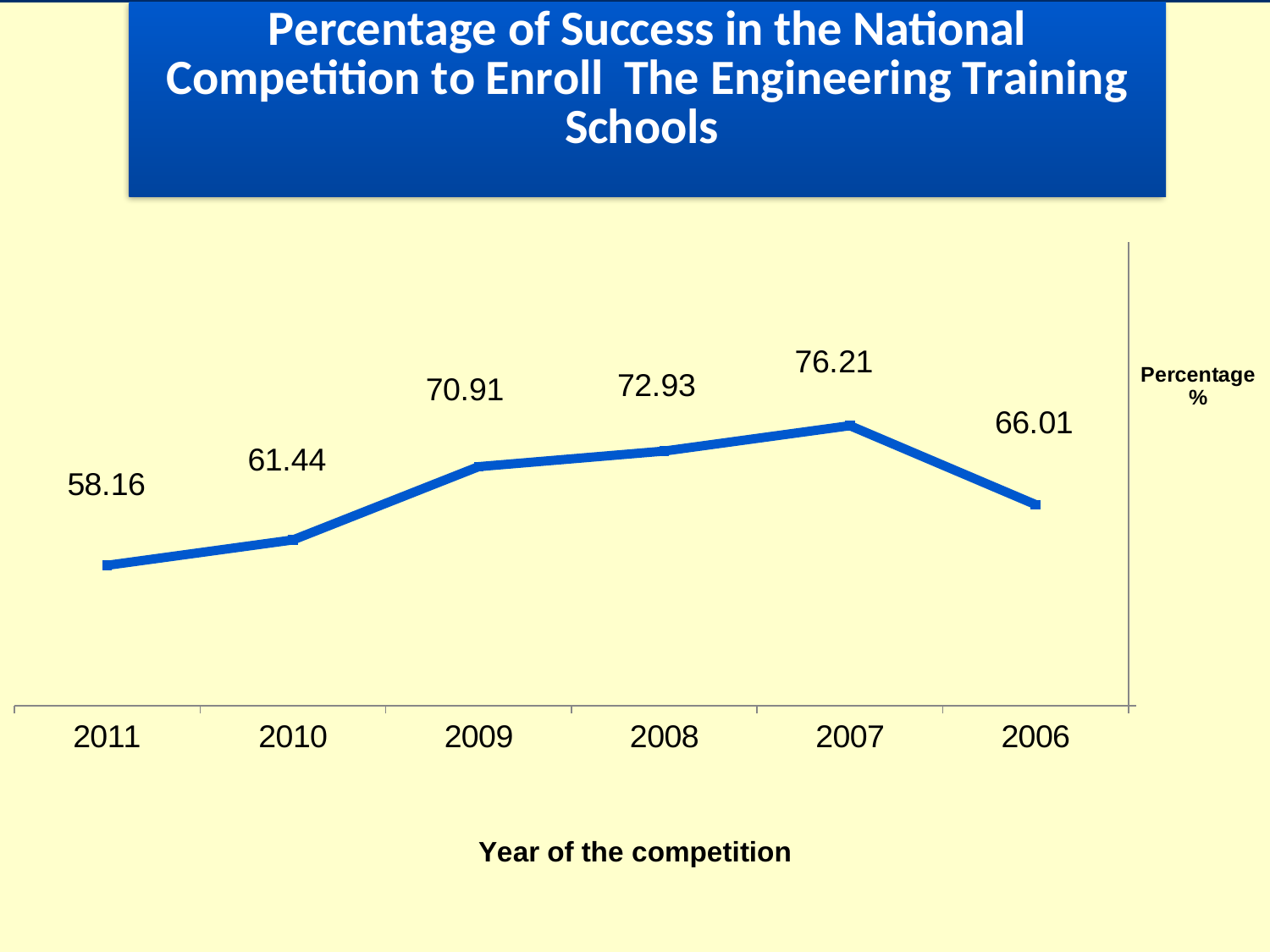
What is the percentage of success for 2009? 70.91 Which year has the lowest percentage of success? 2011 What is the percentage of success for 2006? 66.01 Do the values rise or fall from 2011 to 2007 along the x axis? Rise Which year has the highest percentage of success? 2007 What is the difference between the percentage of success in 2007 and in 2006? 10.2 How many years are plotted on the chart? 6 What is the percentage of success for 2011? 58.16 What is the label of the x axis? Year of the competition Which year has a higher percentage of success, 2008 or 2006? 2008 What kind of chart is shown on the slide? Line chart What is the difference between the percentage of success in 2010 and in 2011? 3.28